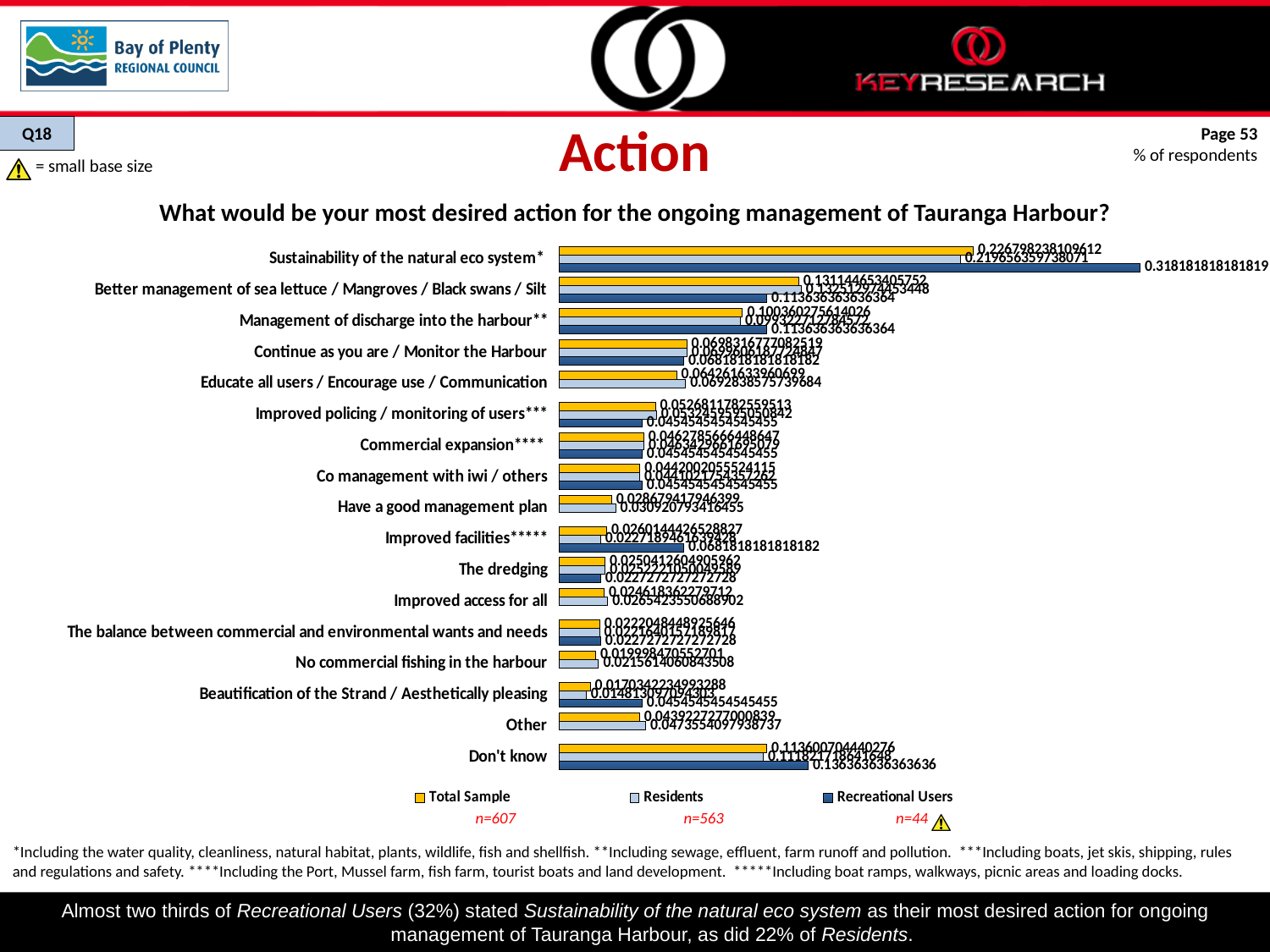
How many categories (actions) are plotted on the chart? 17 Which category has the highest value for Recreational Users? Sustainability of the natural eco system* What is the difference between the Recreational Users values for 'Sustainability of the natural eco system*' and 'Don't know'? 0.181818181818183 What is the Recreational Users value for 'Improved facilities*****'? 0.0681818181818182 What is the Total Sample value for 'Sustainability of the natural eco system*'? 0.226798238109612 How many series does the chart legend list? 3 For 'Sustainability of the natural eco system*', which is larger: the Recreational Users value or the Residents value? Recreational Users What is the Recreational Users value for 'Sustainability of the natural eco system*'? 0.318181818181819 What is the sample size (n) shown for the Recreational Users series? n=44 What is the Recreational Users value for 'Don't know'? 0.136363636363636 What kind of chart is shown on the slide? bar chart For 'Improved facilities*****', which is larger: the Recreational Users value or the Total Sample value? Recreational Users